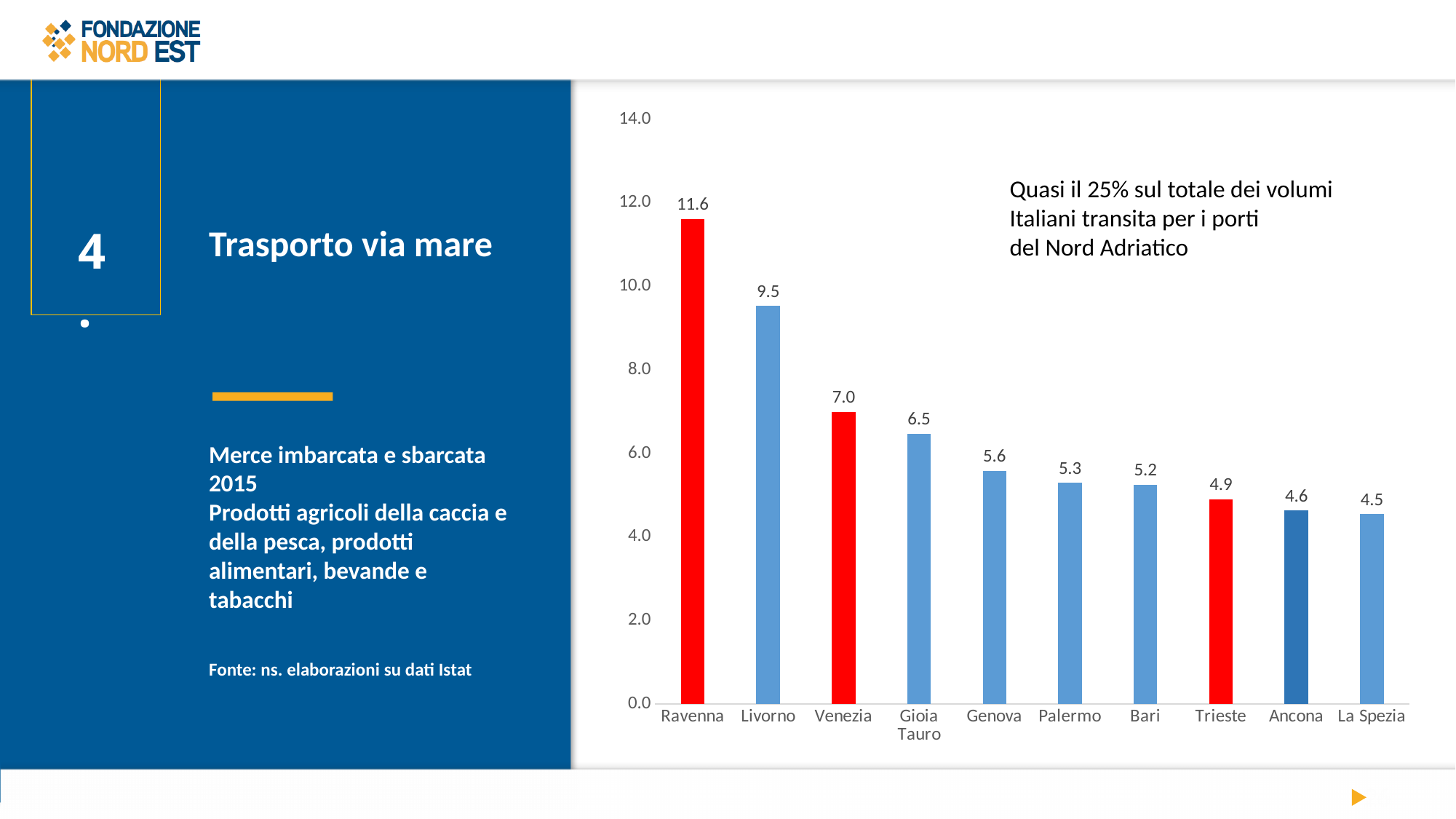
What is the value for Ravenna? 11.6 What kind of chart is shown on the slide? bar chart Which is larger, the value for Gioia Tauro or the value for Genova? Gioia Tauro What is the difference between the values for Ravenna and Livorno? 2.1 Is the value for Livorno greater or less than 10.0? less What is the value for Trieste? 4.9 Which ports are shown with red bars? Ravenna, Venezia, Trieste What is the value for Venezia? 7.0 How many ports are shown on the chart? 10 Which port has the highest value? Ravenna Which port has the lowest value? La Spezia Do the values rise or fall from left to right along the x axis? fall